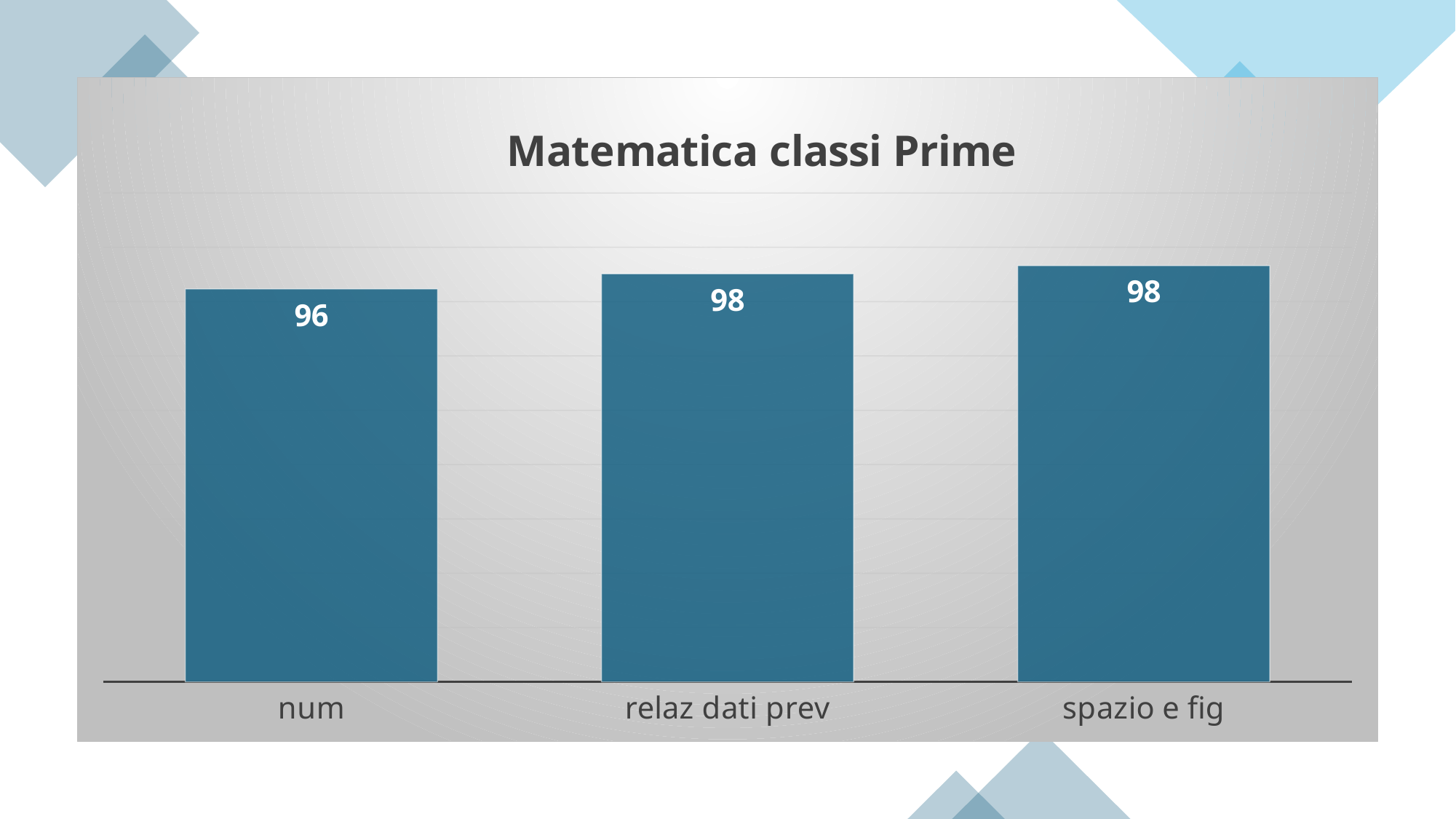
What is the title of the chart? Matematica classi Prime What is the value for num? 96 Which category has the lowest value? num What kind of chart is shown on the slide? bar chart What is the difference between the values for relaz dati prev and num? 2 Which two categories share the same value? relaz dati prev and spazio e fig Do the values rise or fall from num to relaz dati prev? rise Which is larger, the value for num or the value for spazio e fig? spazio e fig What is the value for relaz dati prev? 98 How many categories are shown on the x axis? 3 What is the value for spazio e fig? 98